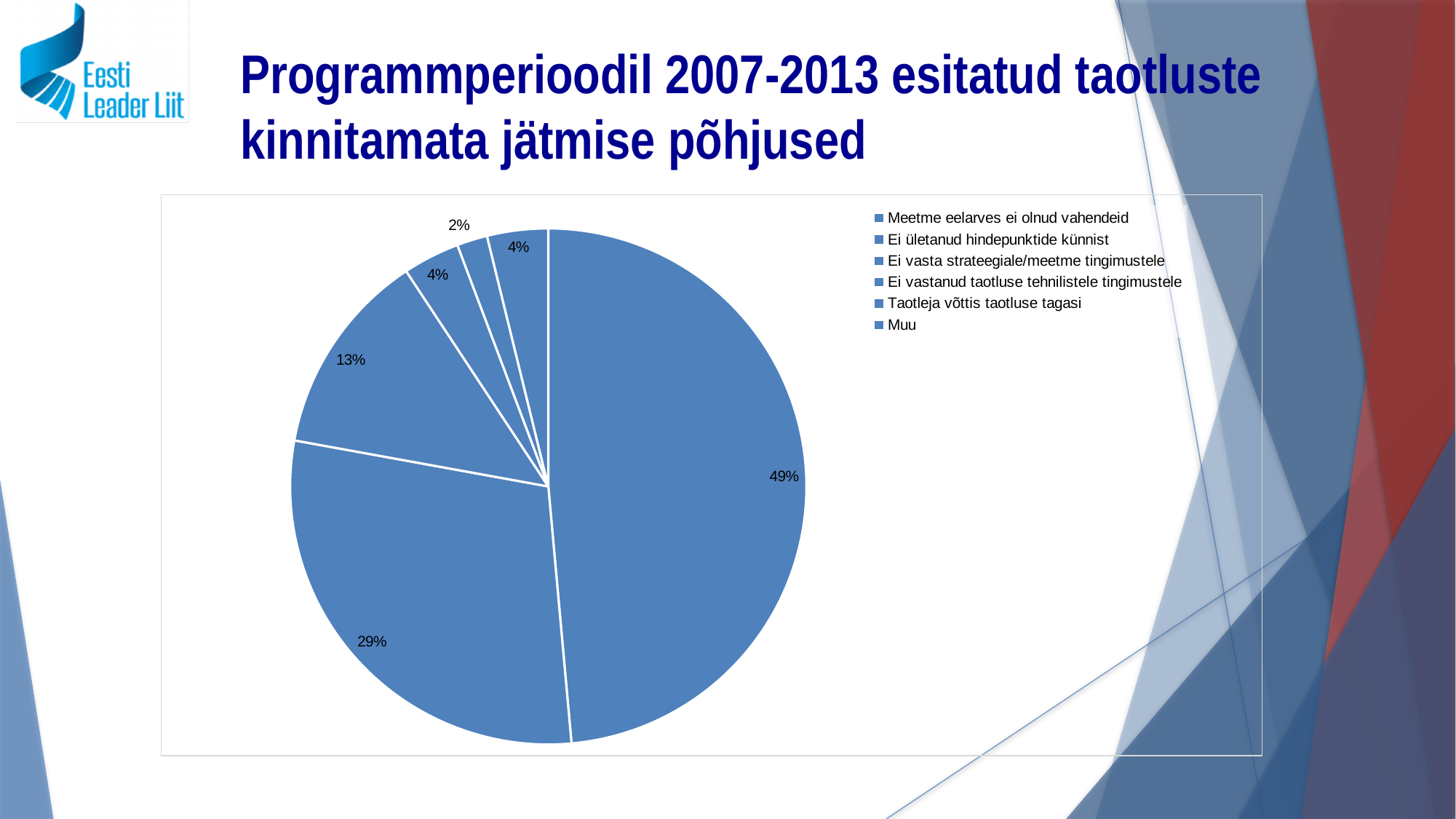
What is the first entry listed in the chart legend? Meetme eelarves ei olnud vahendeid How many slices does the pie chart have? 6 What is the percentage shown on the smallest slice of the pie chart? 2% What is the difference in percentage points between the largest slice (49%) and the second-largest slice (29%)? 20 What is the combined share of the two slices labelled 29% and 13%? 42% What is the last entry listed in the chart legend? Muu How many slices of the pie chart are labelled 4%? 2 What is the difference in percentage points between the 13% slice and the 2% slice? 11 What is the percentage shown on the largest slice of the pie chart? 49% Which is larger, the slice labelled 29% or the slice labelled 13%? 29% What kind of chart is shown on the slide? pie chart How many entries does the legend of the pie chart list? 6